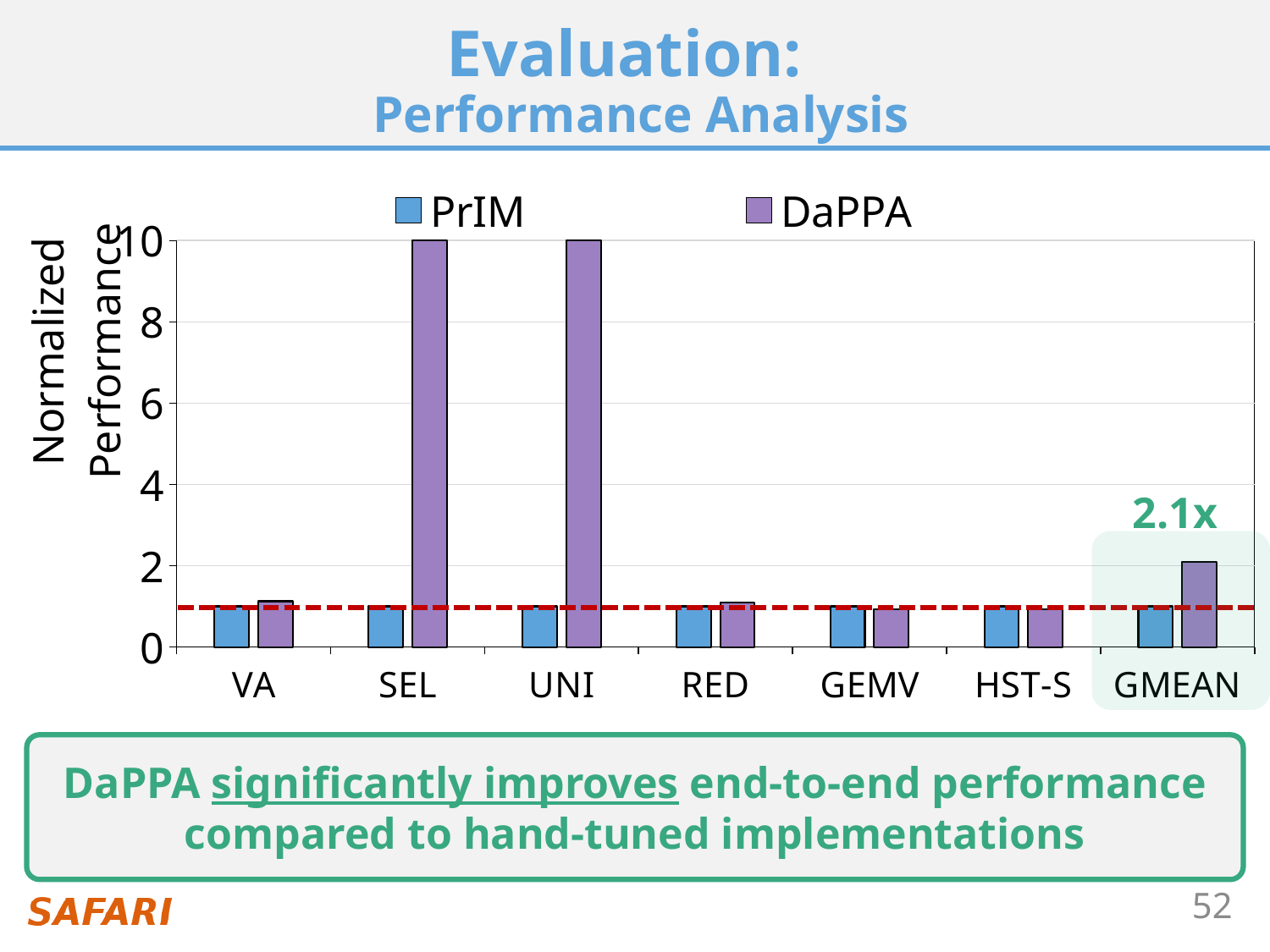
What is the label of the y axis? Normalized Performance What value is labelled above the DaPPA bar for GMEAN? 2.1x Which is larger, the DaPPA value for SEL or the DaPPA value for RED? SEL Is the DaPPA value for SEL greater or less than 8? greater What are the two series named in the legend? PrIM and DaPPA Is the DaPPA value for GMEAN greater or less than 4? less How many categories are shown on the x axis? 7 Is the DaPPA value for VA greater or less than 2? less What kind of chart is shown on the slide? bar chart How many series does the legend list? 2 For GMEAN, which series has the larger value, PrIM or DaPPA? DaPPA